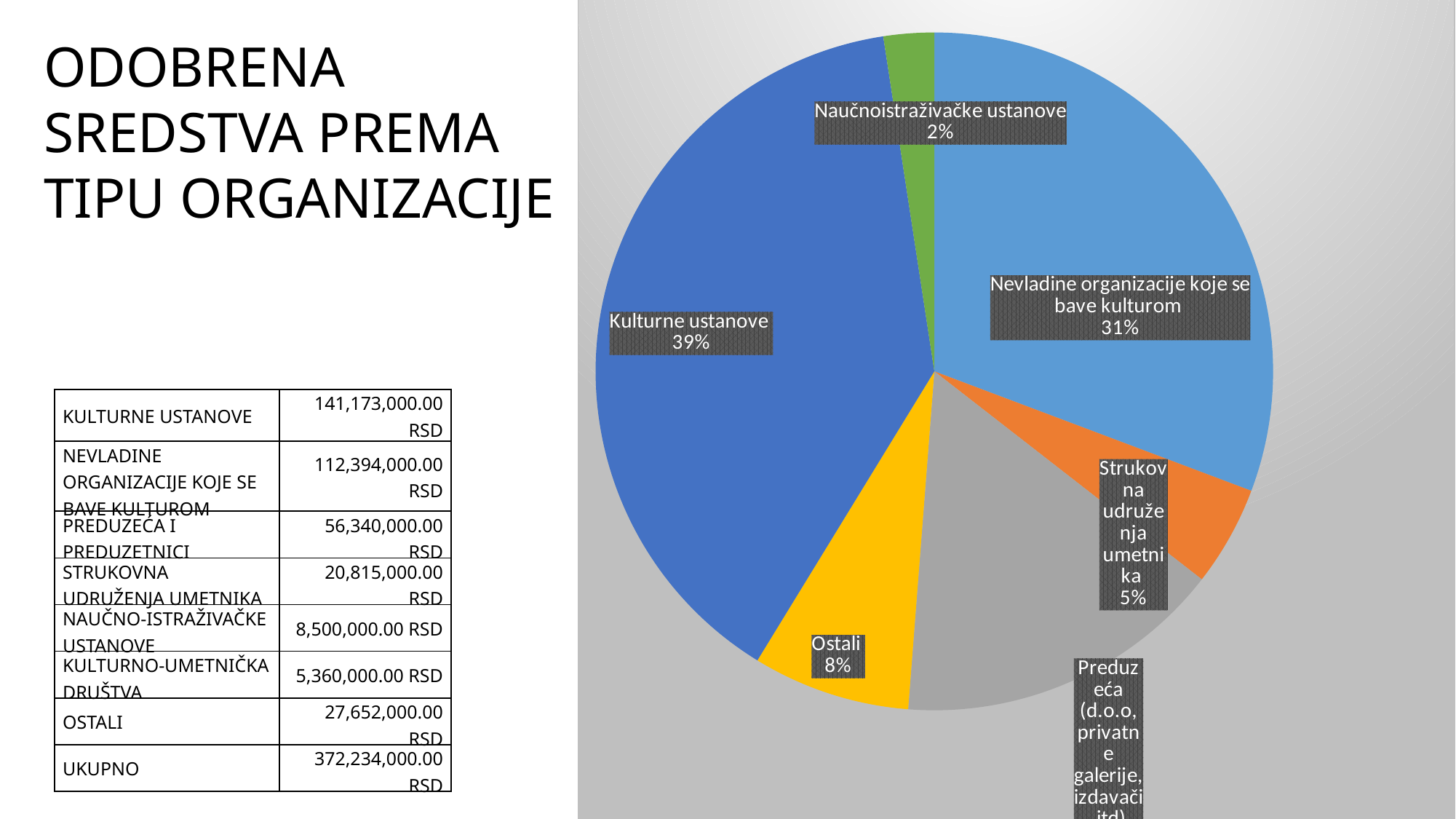
What share of the pie does Kulturne ustanove have? 39% How many slices does the pie chart have? 6 What share of the pie does Strukovna udruženja umetnika have? 5% Which category has the largest slice of the pie? Kulturne ustanove By how many percentage points does the share of Kulturne ustanove exceed that of Nevladine organizacije koje se bave kulturom? 8 percentage points Which category has the smallest slice of the pie? Naučnoistraživačke ustanove Which category is shown by the green slice of the pie? Naučnoistraživačke ustanove What kind of chart is shown on the slide? pie chart What share of the pie does Nevladine organizacije koje se bave kulturom have? 31% Which has a larger share of the pie, Ostali or Strukovna udruženja umetnika? Ostali What share of the pie does Ostali have? 8% What share of the pie does Naučnoistraživačke ustanove have? 2%